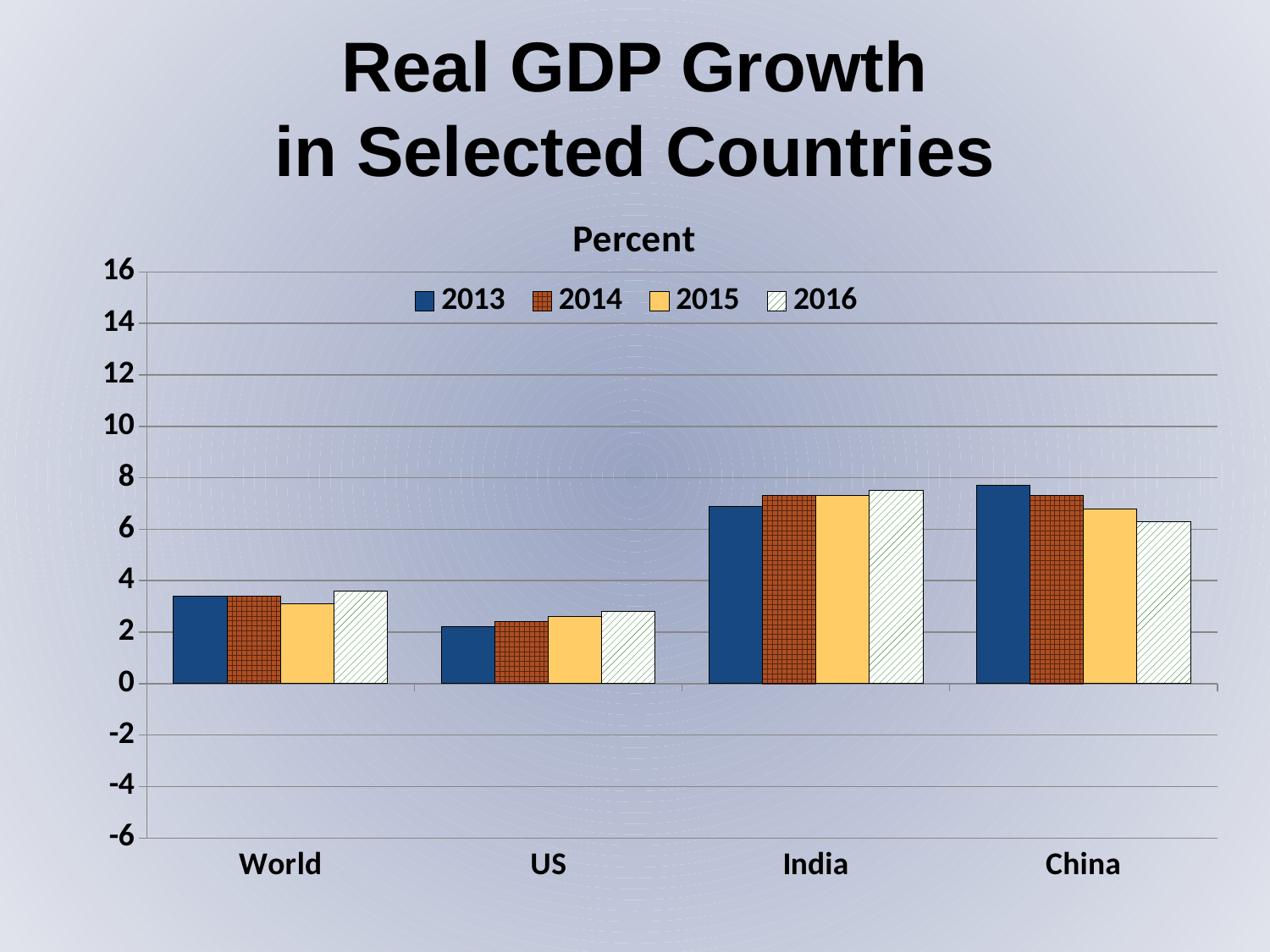
Which is larger in 2016, the value for India or the value for China? India Is the value for India in 2016 greater or less than 8? less Which years are listed in the chart legend? 2013, 2014, 2015, 2016 What kind of chart is shown on the slide? bar chart Is the value for China in 2013 greater or less than 6? greater How many series does the legend list? 4 Is the value for US in 2013 greater or less than 4? less Do the values for US rise or fall from 2013 to 2016? rise Which country/region has the lowest value in 2016? US How many countries/regions are shown on the x axis? 4 Do the values for China rise or fall from 2013 to 2016? fall Which country/region has the highest value in 2013? China